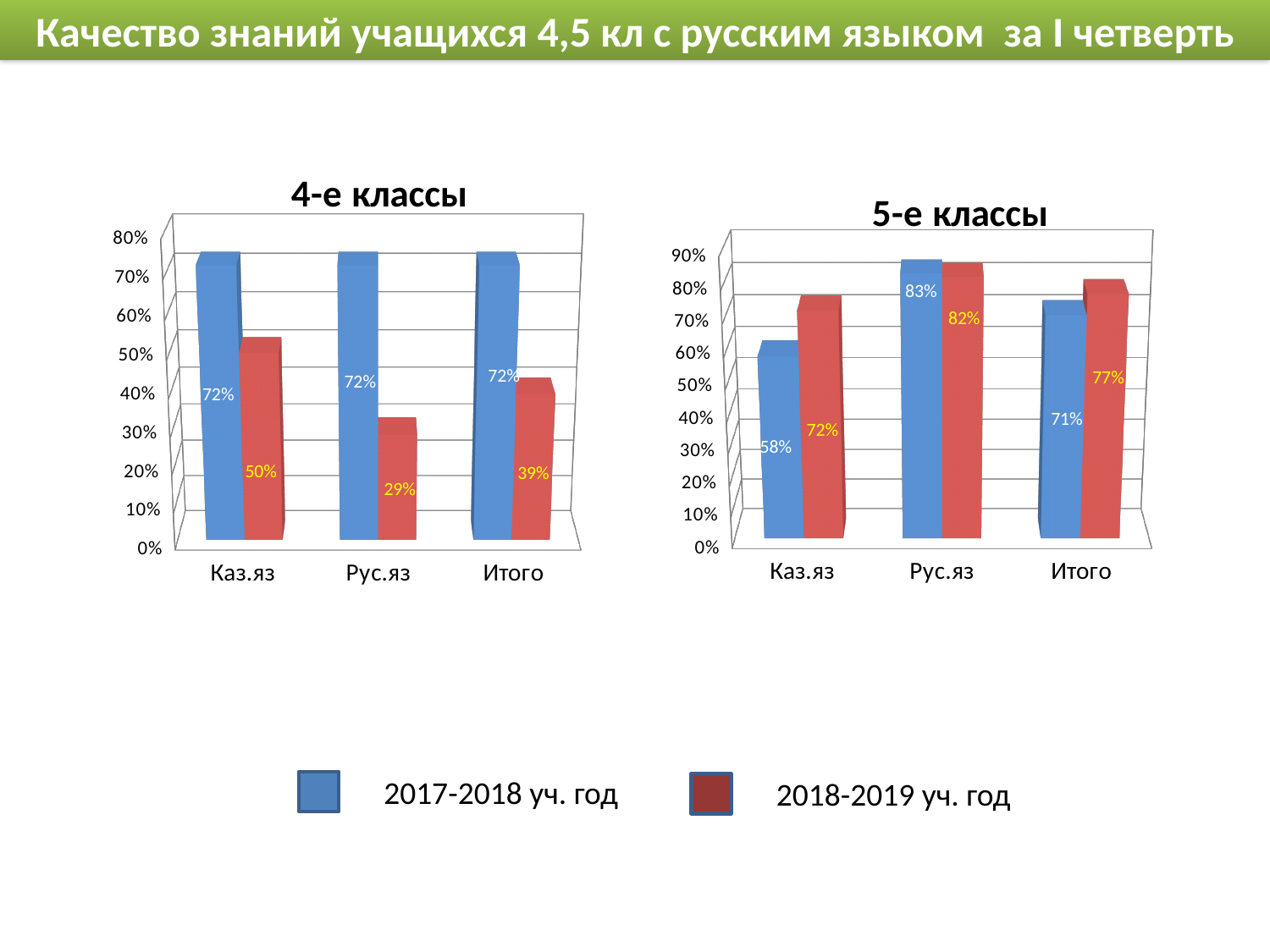
How many categories are shown on the x axis of the "4-е классы" chart? 3 How many series does the legend at the bottom of the slide list? 2 In the "5-е классы" chart, which is larger for Итого: the 2017-2018 value or the 2018-2019 value? 2018-2019 уч. год In the "4-е классы" chart, is the value for Итого in 2018-2019 уч. год greater or less than 40%? less In the "5-е классы" chart, what is the value for Каз.яз in 2017-2018 уч. год? 58% In the "5-е классы" chart, what is the value for Итого in 2018-2019 уч. год? 77% In the "4-е классы" chart, what is the value for Рус.яз in 2018-2019 уч. год? 29% In the "4-е классы" chart, which category has the lowest value for 2018-2019 уч. год? Рус.яз In the "4-е классы" chart, what is the difference between the 2017-2018 and 2018-2019 values for Каз.яз? 22% What kind of chart is the "5-е классы" chart? Bar chart In the "5-е классы" chart, what is the difference between the 2018-2019 and 2017-2018 values for Каз.яз? 14% In the "5-е классы" chart, which category has the highest value for 2017-2018 уч. год? Рус.яз